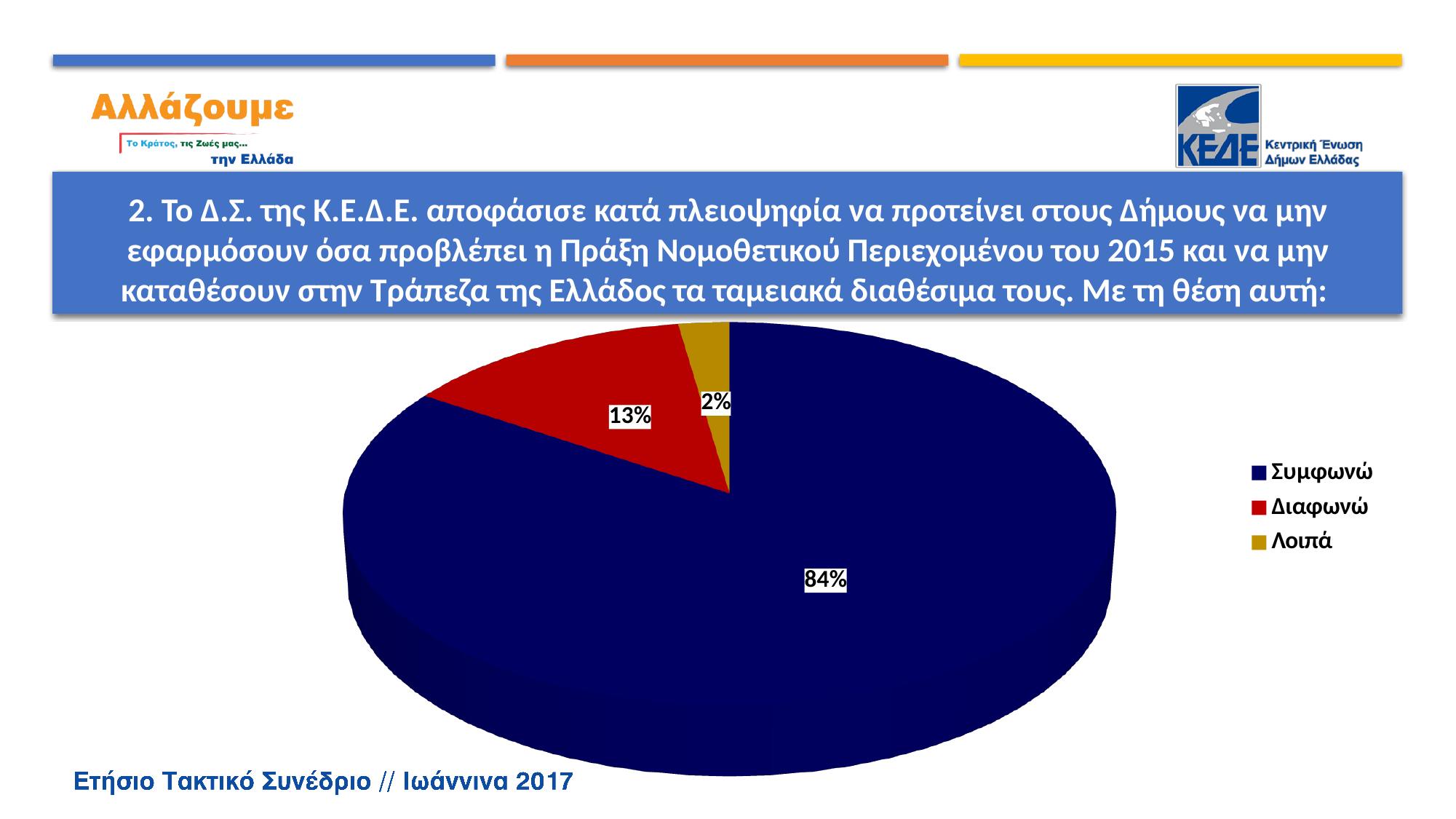
What is the difference in percentage points between Συμφωνώ and Διαφωνώ? 71 How many categories does the pie chart have? 3 What is the difference in percentage points between Διαφωνώ and Λοιπά? 11 What colour is the slice for Διαφωνώ? red Which category has the smallest slice of the pie? Λοιπά Which category is shown in dark blue in the legend? Συμφωνώ What share of the pie does Λοιπά have? 2% Which is larger, the slice for Διαφωνώ or the slice for Λοιπά? Διαφωνώ Which category has the largest slice of the pie? Συμφωνώ What kind of chart is shown on the slide? pie chart What share of the pie does Διαφωνώ have? 13% What share of the pie does Συμφωνώ have? 84%